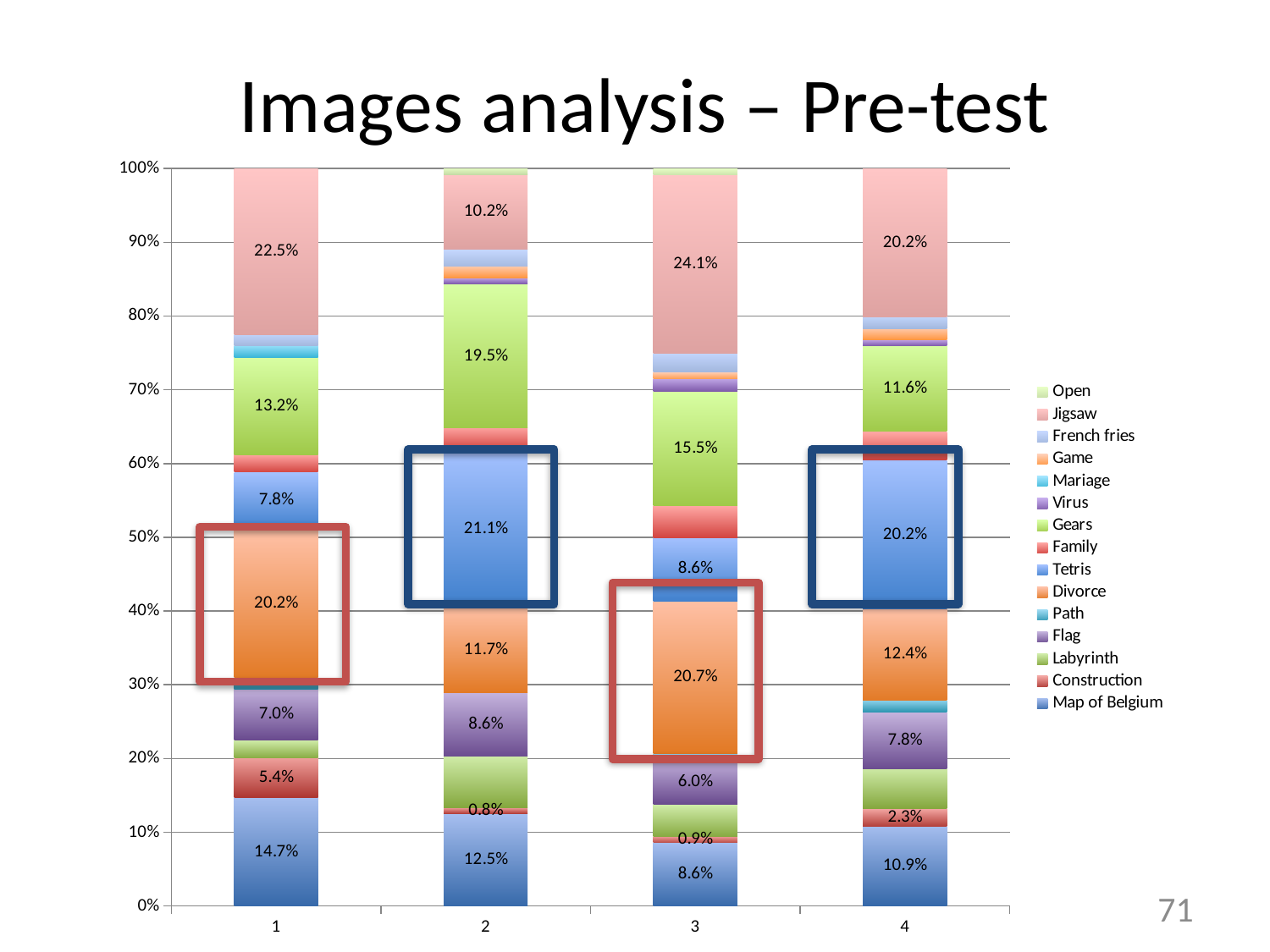
What is the difference between the Gears values for category 2 and category 4? 7.9% What is the value of the Tetris segment for category 2? 21.1% How many series does the legend list? 15 Which category has the highest Jigsaw value? 3 What is the value of the Map of Belgium segment for category 4? 10.9% What is the value of the Jigsaw segment for category 3? 24.1% Which category has the lowest Construction value? 2 How many categories are shown on the x axis? 4 Which is larger, the Flag value for category 2 or for category 3? category 2 What is the title of the chart? Images analysis – Pre-test What kind of chart is shown on the slide? stacked bar chart What is the value of the Divorce segment for category 1? 20.2%